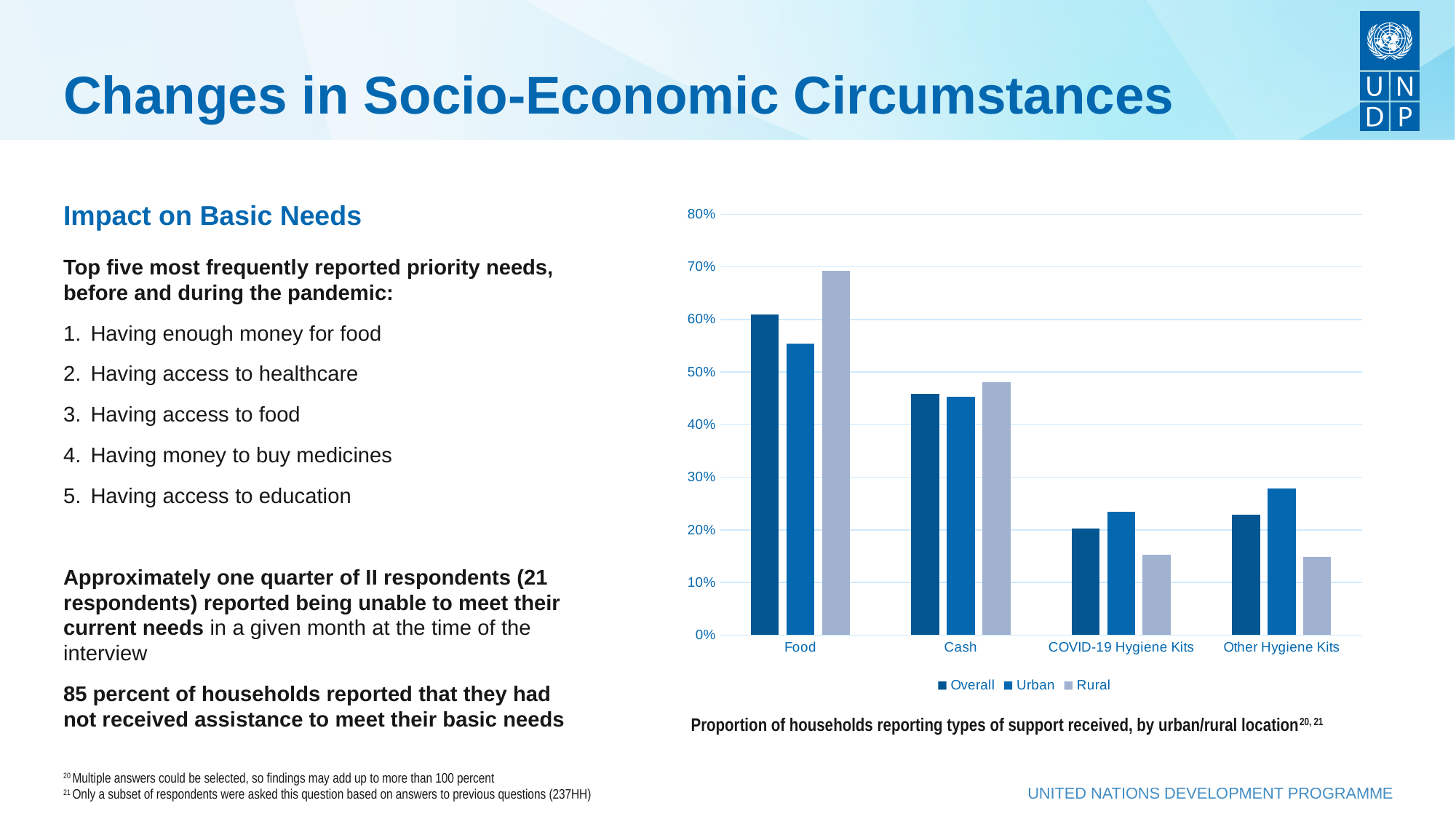
Is the Urban value for Food greater or less than 50%? greater Is the Urban value for Other Hygiene Kits greater or less than 20%? greater Is the Rural value for Food greater or less than 60%? greater How many series does the chart legend list? 3 How many categories are shown on the x axis of the chart? 4 Which category has the highest Rural value? Food What kind of chart is shown on the slide? bar chart Which series are listed in the chart legend? Overall, Urban, Rural For Food, which is larger: the Rural value or the Urban value? Rural What is the title of the chart? Proportion of households reporting types of support received, by urban/rural location Which category has the highest Urban value? Food